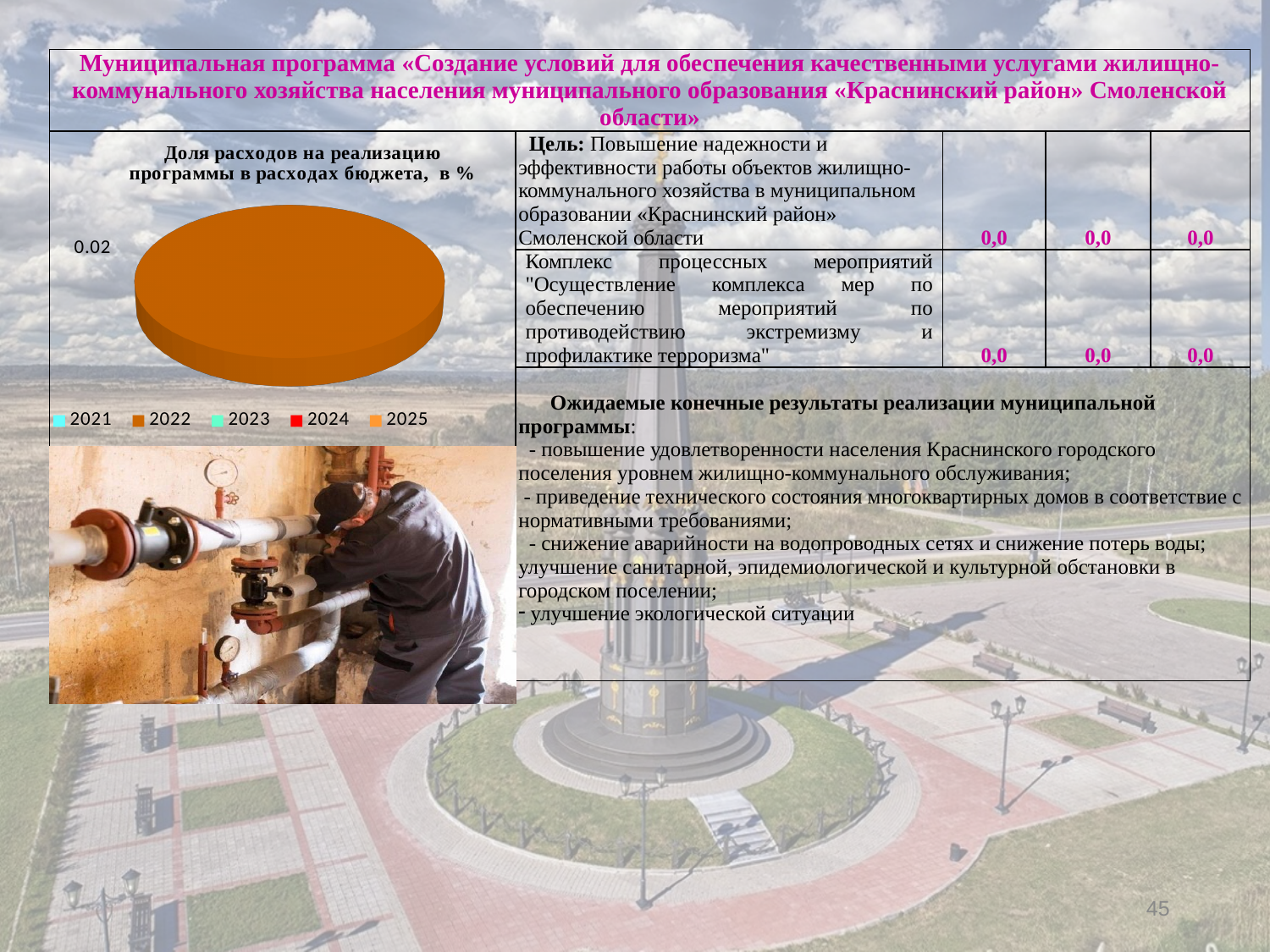
What kind of chart is shown on the slide? pie chart What is the title of the chart on the slide? Доля расходов на реализацию программы в расходах бюджета, в % Which years are listed in the chart's legend? 2021, 2022, 2023, 2024, 2025 What is the value shown for 2022 on the pie chart? 0.02 How many entries does the chart's legend list? 5 What value is printed as the data label on the pie chart? 0.02 Which year's slice takes up the largest part of the pie? 2022 How many slices are visibly drawn in the pie chart? 1